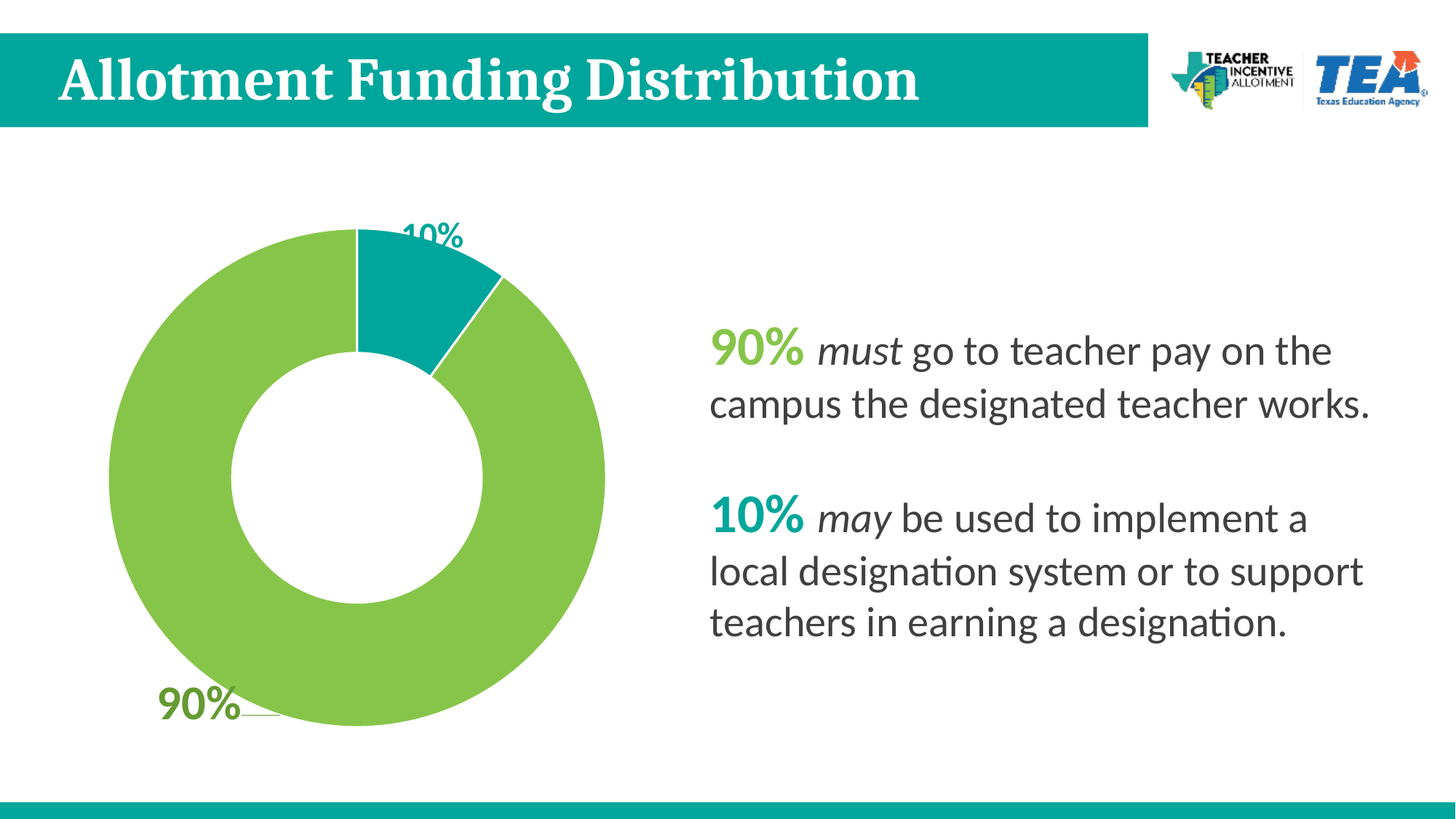
How many slices does the doughnut chart have? 2 What kind of chart is shown on the slide? Doughnut (pie) chart What share of the doughnut chart is the green slice? 90% What do the two slices of the doughnut chart add up to? 100% What is the title of the slide containing the doughnut chart? Allotment Funding Distribution What colour is the 10% slice of the doughnut chart? Teal Is the green slice or the teal slice larger in the doughnut chart? The green slice What is the difference in percentage points between the two slices of the doughnut chart? 80 What share of the doughnut chart is the teal slice? 10% Which slice of the doughnut chart is the smallest? The teal 10% slice Which slice of the doughnut chart is the largest? The green 90% slice